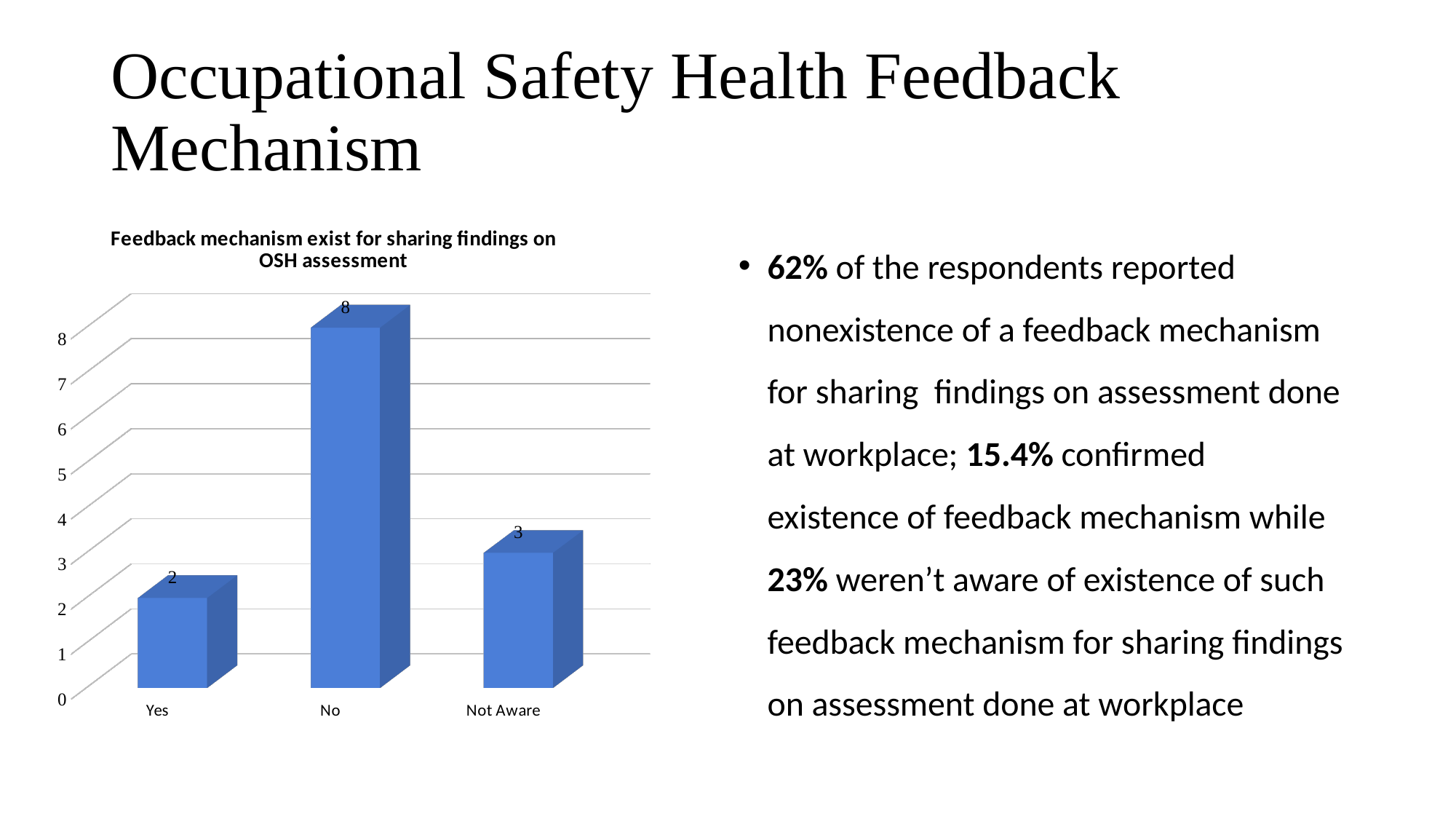
What is the value for "Yes" in the chart? 2 What is the value for "Not Aware" in the chart? 3 What is the title of the chart? Feedback mechanism exist for sharing findings on OSH assessment What kind of chart is shown on the slide? bar chart What is the difference between the values for "Not Aware" and "Yes"? 1 Which category has the highest value in the chart? No Which is larger, the value for "Yes" or the value for "Not Aware"? Not Aware Which category has the lowest value in the chart? Yes What is the difference between the values for "No" and "Not Aware"? 5 Is the value for "No" greater or less than 5? greater What is the value for "No" in the chart? 8 How many categories are shown on the x axis of the chart? 3